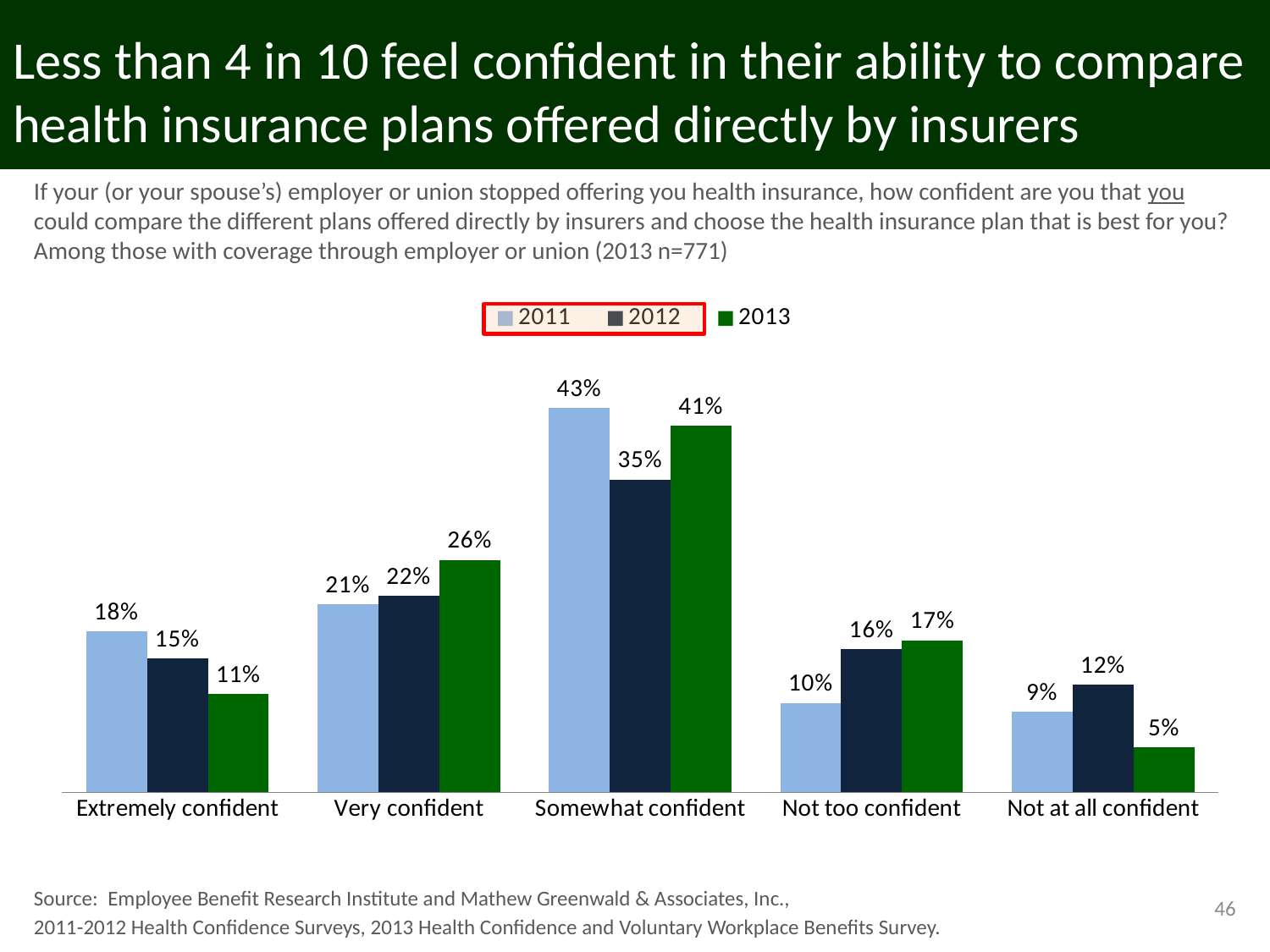
Which is larger for Not too confident: the 2011 value or the 2013 value? 2013 Which category has the lowest 2013 value? Not at all confident What is the 2013 value for Somewhat confident? 41% How many series does the legend list? 3 How many categories are shown on the x axis? 5 What kind of chart is shown on the slide? Bar chart Which legend entries are outlined with a red box? 2011 and 2012 What is the difference between the 2011 and 2012 values for Somewhat confident? 8% What is the difference between the 2013 and 2011 values for Very confident? 5% What is the 2011 value for Extremely confident? 18% Which category has the highest 2011 value? Somewhat confident What is the 2012 value for Not at all confident? 12%